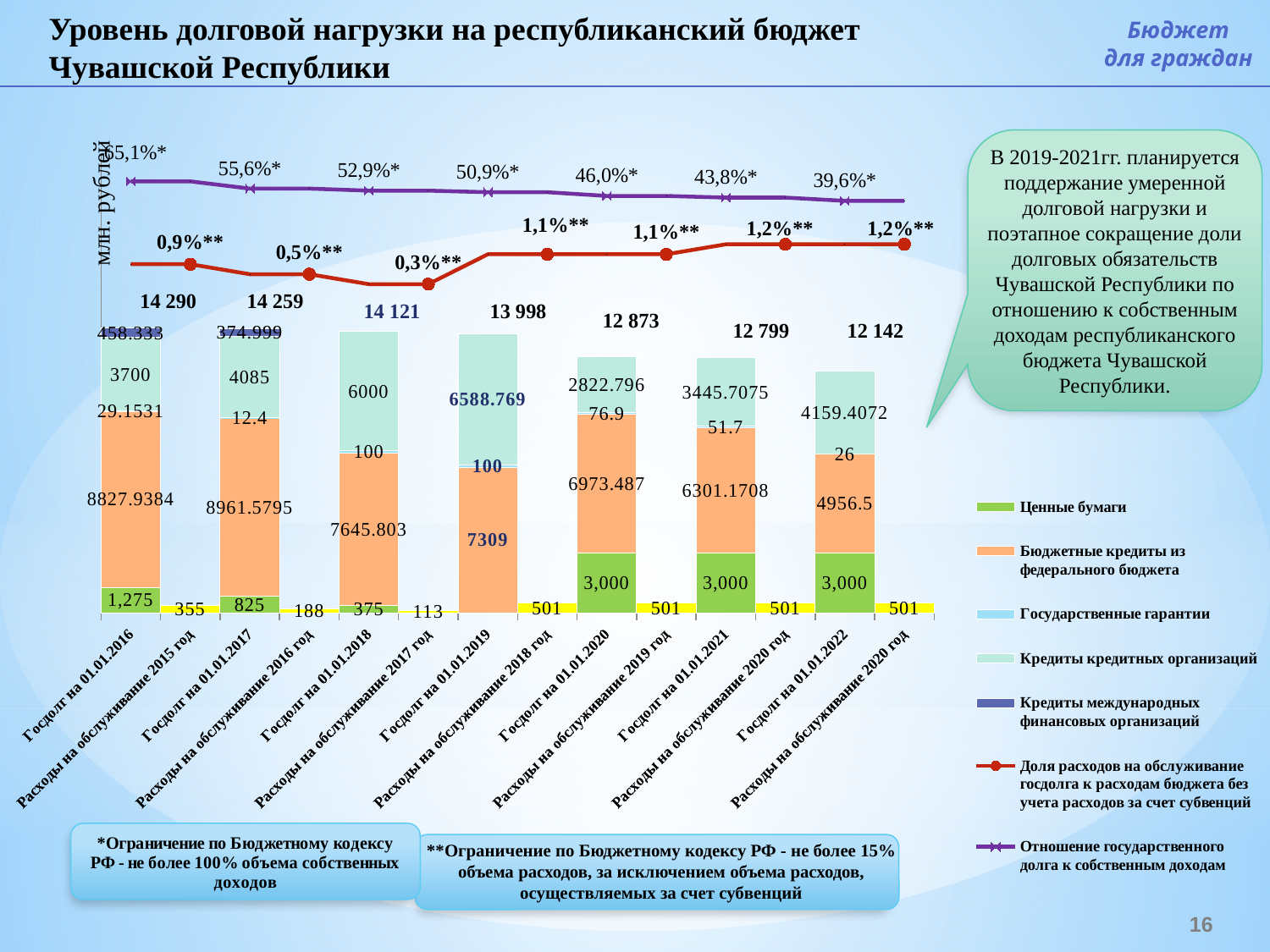
What value does the purple line (Отношение государственного долга к собственным доходам) show for 01.01.2022? 39,6% What is the difference between the total state debt on 01.01.2016 (14 290) and on 01.01.2022 (12 142)? 2 148 How many series does the legend list? 7 What is the value of Расходы на обслуживание 2017 год? 113 Which date has the lowest total state debt (Госдолг)? 01.01.2022 Does the purple line (Отношение государственного долга к собственным доходам) rise or fall from 01.01.2016 to 01.01.2022? fall What kind of chart is used to show the state debt structure? stacked bar chart with line series What is the value of Бюджетные кредиты из федерального бюджета for Госдолг на 01.01.2022? 4956.5 Which is larger: Кредиты кредитных организаций on 01.01.2018 or on 01.01.2020? 01.01.2018 What value does the red line (Доля расходов на обслуживание госдолга) show for 01.01.2019? 1,1% Which date has the highest total state debt (Госдолг)? 01.01.2016 What is the total state debt (Госдолг) shown above the bar for 01.01.2016? 14 290